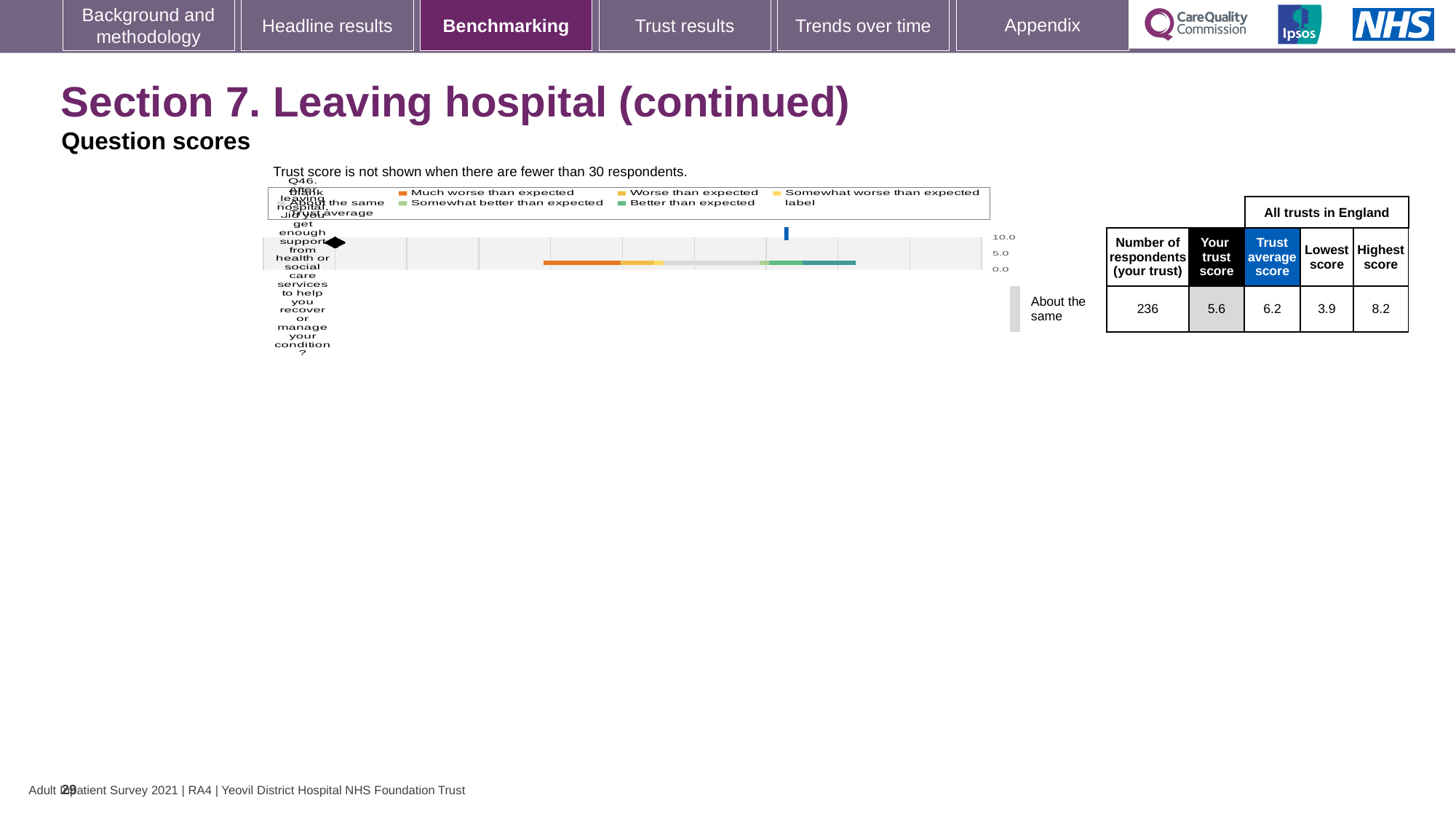
Which is larger for Q46: the trust's own score or the trust average score? Trust average score What is the maximum value shown on the chart's score axis? 10.0 What is the trust score for Q46 shown on the slide? 5.6 What is the difference between the trust average score and this trust's score for Q46? 0.6 What is the lowest score among all trusts in England for Q46? 3.9 What is the highest score among all trusts in England for Q46? 8.2 What benchmark category is the trust's Q46 score placed in? About the same How many respondents from the trust answered Q46? 236 Which legend entry is shown in orange on the chart? Much worse than expected What is the difference between the highest score and the lowest score for Q46 across all trusts in England? 4.3 Is the trust score for Q46 greater or less than 5.0 on the chart axis? greater What is the trust average score for Q46 across all trusts in England? 6.2